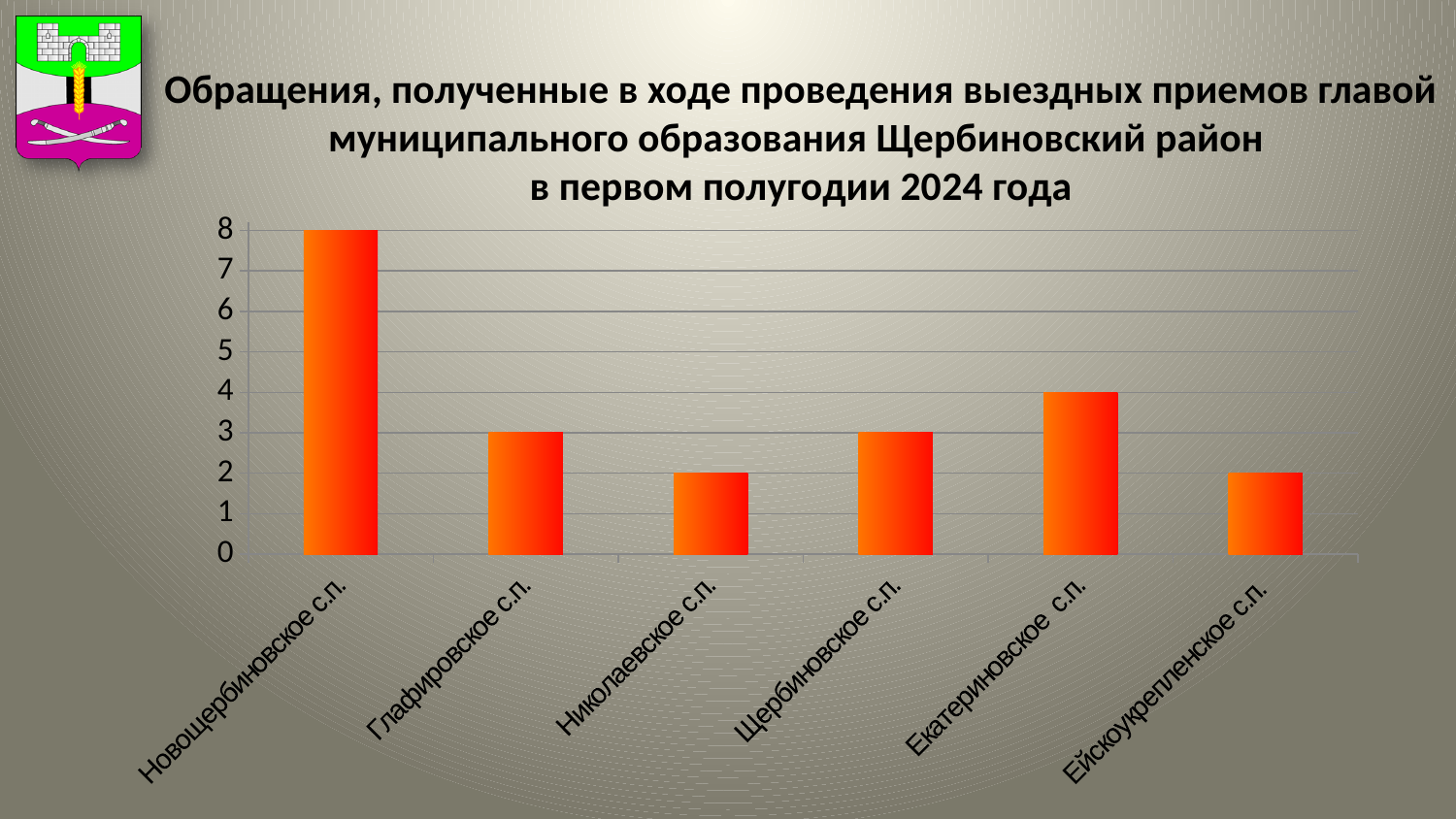
What is the value for Глафировское с.п.? 3 How many categories (settlements) are shown on the x axis? 6 Which is larger, the value for Щербиновское с.п. or the value for Ейскоукрепленское с.п.? Щербиновское с.п. Which category has the highest value? Новощербиновское с.п. What type of chart is shown on the slide? bar chart Which period does the chart title say the data covers? в первом полугодии 2024 года Is the value for Екатериновское с.п. greater or less than 5? less What is the difference between the values for Новощербиновское с.п. and Екатериновское с.п.? 4 What is the value for Екатериновское с.п.? 4 What is the value for Новощербиновское с.п.? 8 What is the maximum value shown on the vertical axis? 8 What is the value for Николаевское с.п.? 2